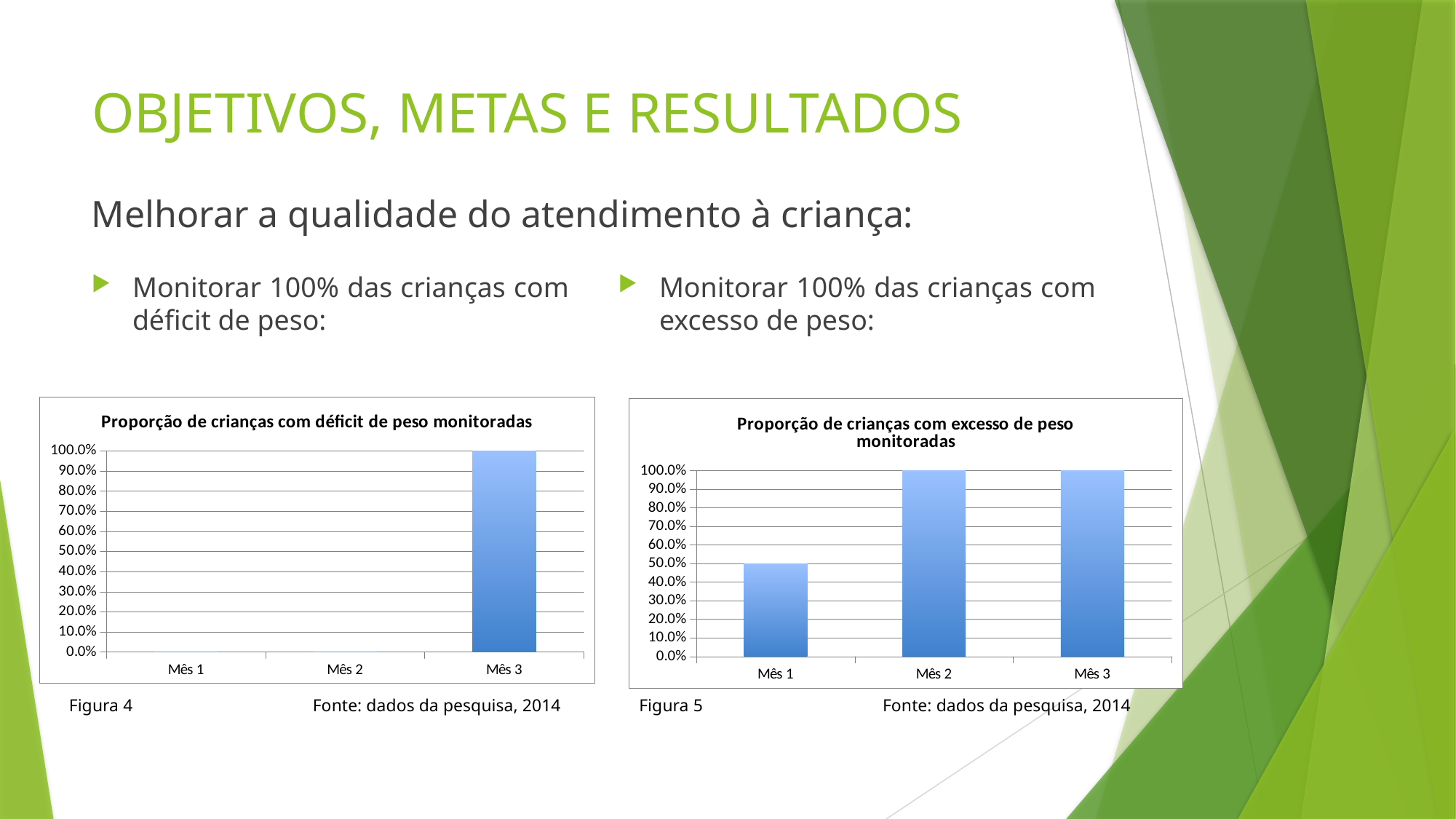
How many categories are shown on the x axis of the chart titled 'Proporção de crianças com déficit de peso monitoradas'? 3 What is the figure number given below the left chart on the slide? Figura 4 In the chart titled 'Proporção de crianças com déficit de peso monitoradas', which month has the highest value? Mês 3 In the chart titled 'Proporção de crianças com excesso de peso monitoradas', what is the difference between the values for Mês 2 and Mês 1? 50.0% In the chart titled 'Proporção de crianças com excesso de peso monitoradas', what is the value for Mês 2? 100.0% In the chart titled 'Proporção de crianças com déficit de peso monitoradas', what is the value for Mês 3? 100.0% What kind of chart is the chart titled 'Proporção de crianças com excesso de peso monitoradas'? bar chart In the chart titled 'Proporção de crianças com excesso de peso monitoradas', do the values rise or fall from Mês 1 to Mês 2? rise In the chart titled 'Proporção de crianças com excesso de peso monitoradas', which is larger, the value for Mês 1 or the value for Mês 3? Mês 3 In the chart titled 'Proporção de crianças com excesso de peso monitoradas', which month has the lowest value? Mês 1 In the chart titled 'Proporção de crianças com excesso de peso monitoradas', is the value for Mês 1 greater or less than 60.0%? less In the chart titled 'Proporção de crianças com excesso de peso monitoradas', what is the value for Mês 1? 50.0%